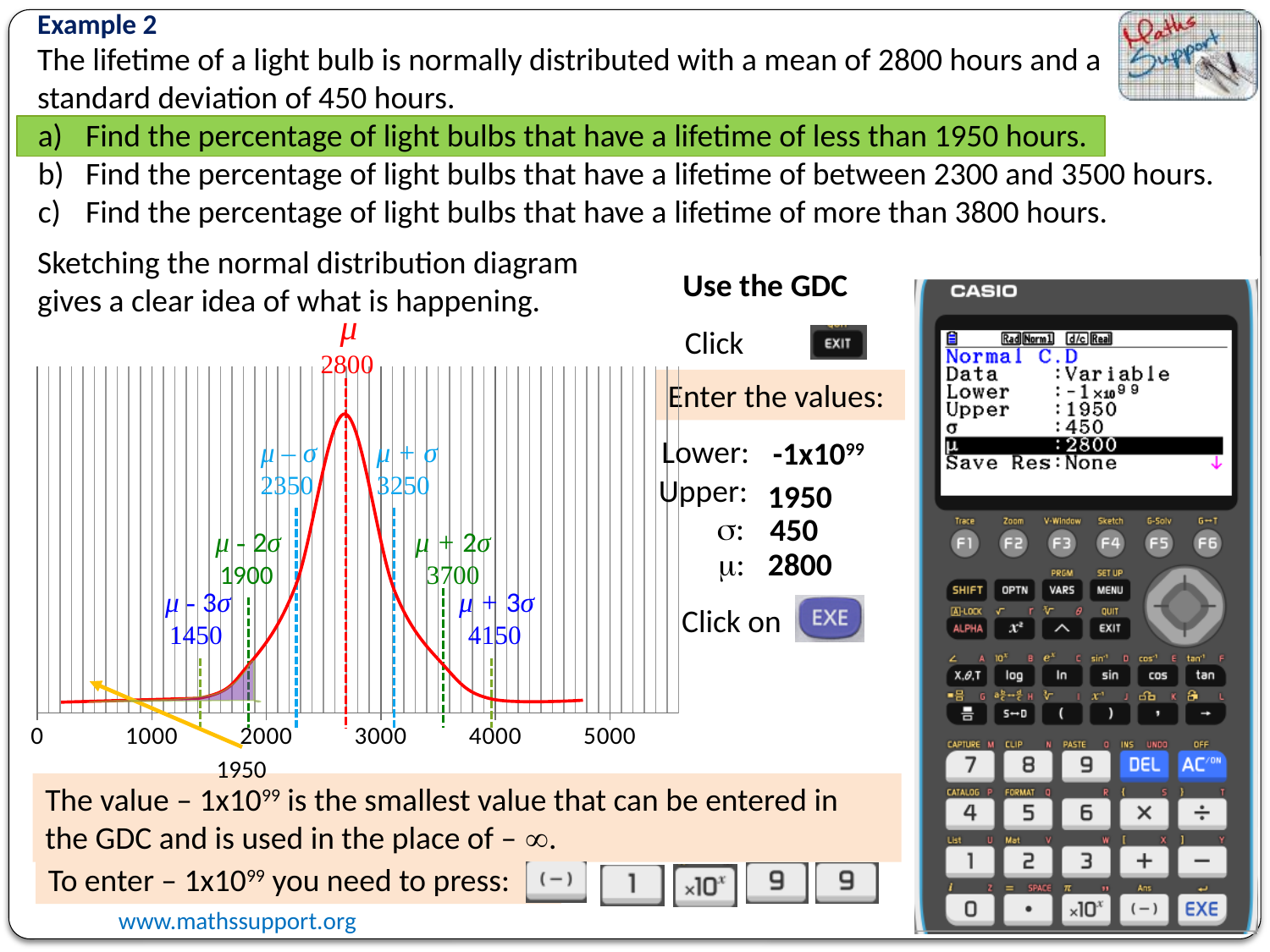
On the normal distribution diagram, what is the difference between the values labelled at μ + σ and μ − σ? 900 On the normal distribution diagram, what is the largest value printed on the horizontal axis? 5000 On the normal distribution diagram, what value is labelled at μ − σ? 2350 On the normal distribution diagram, what value is labelled at μ + σ? 3250 On the normal distribution diagram, what colour is the curve drawn in? Red On the normal distribution diagram, what value is labelled at the mean μ? 2800 On the normal distribution diagram, what value is labelled at μ + 3σ? 4150 On the normal distribution diagram, what value marks the boundary of the shaded region under the curve? 1950 On the normal distribution diagram, what is the difference between the values labelled at μ + 2σ and μ? 900 On the normal distribution diagram, what value is labelled at μ − 3σ? 1450 On the normal distribution diagram, which is larger, the value at μ + 2σ or the value at μ + σ? μ + 2σ On the normal distribution diagram, what value is labelled at μ − 2σ? 1900